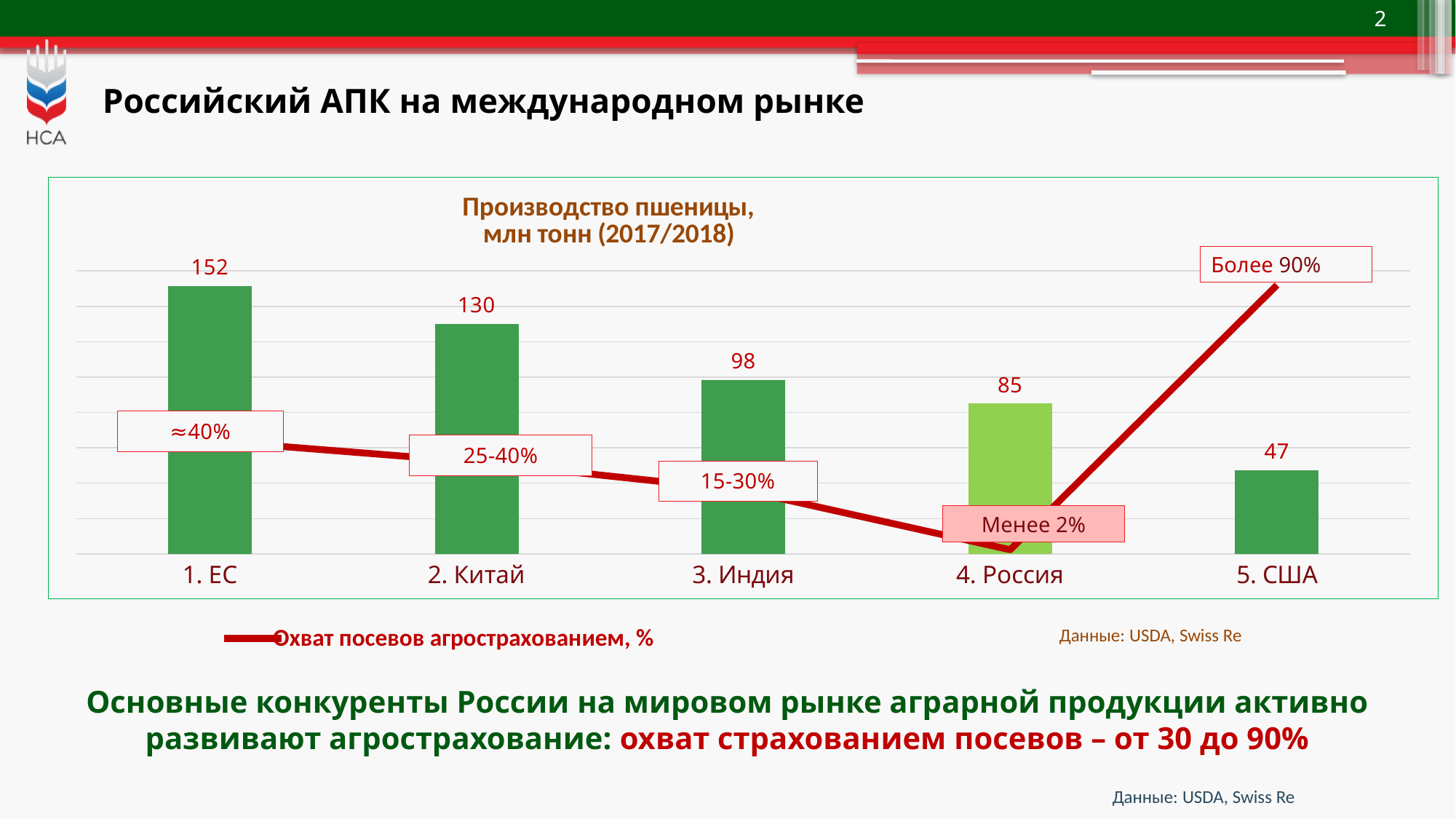
What is the difference in wheat production between 2. Китай and 3. Индия? 32 Do the wheat production bars rise or fall from left to right along the x axis? fall Which category has the lowest wheat production bar? 5. США Which category has the highest wheat production bar? 1. ЕС What is the wheat production value shown for 5. США? 47 Which has a larger wheat production value, 3. Индия or 4. Россия? 3. Индия How many categories (countries/regions) are shown on the x axis of the chart? 5 What crop insurance coverage label is shown for 4. Россия on the line? Менее 2% What is the wheat production value shown for 1. ЕС? 152 What kind of chart is used to show wheat production? bar chart What is the title of the chart? Производство пшеницы, млн тонн (2017/2018) What is the wheat production value shown for 4. Россия? 85